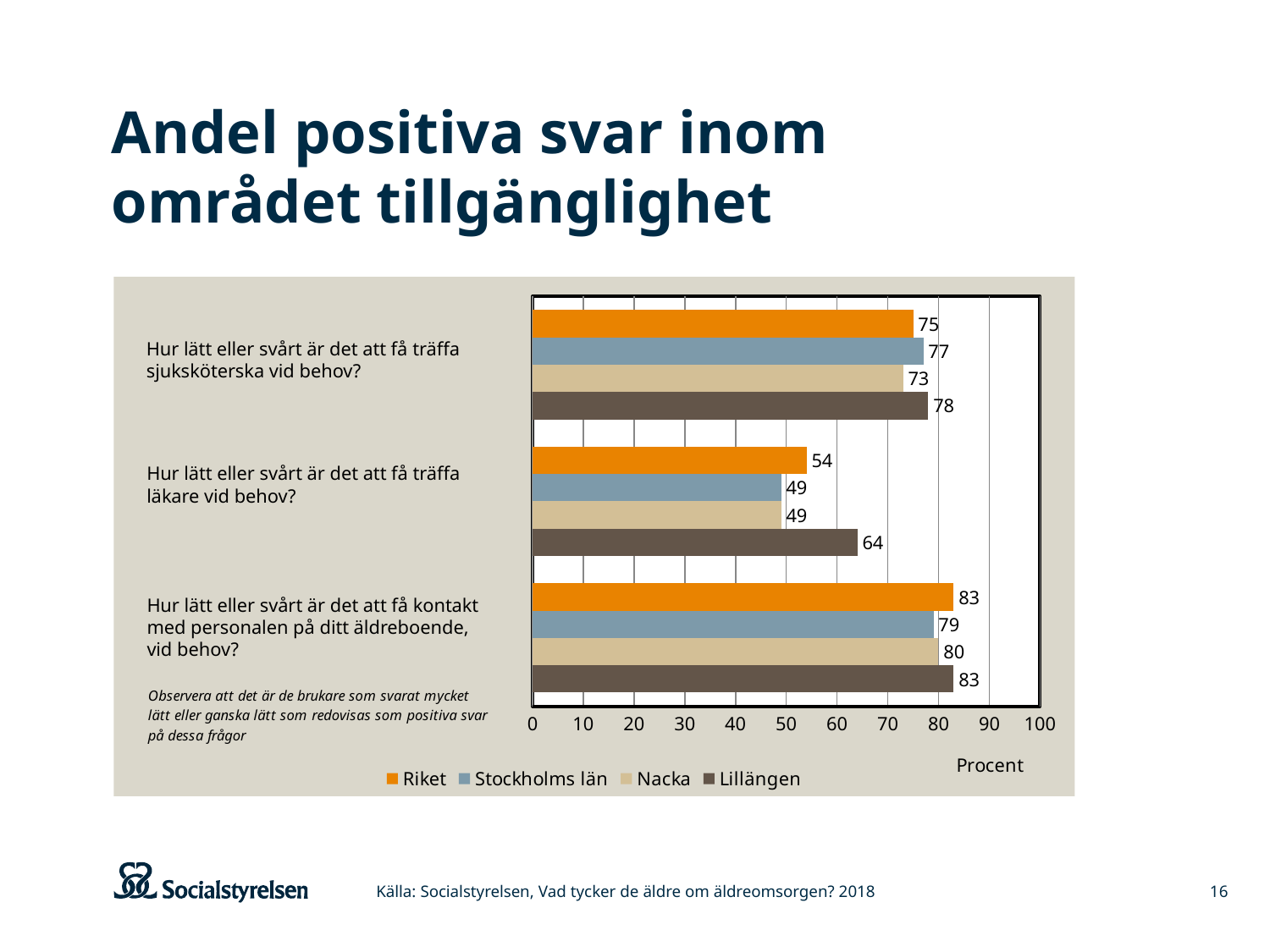
What is the value for Lillängen for the question about meeting a doctor (läkare) when needed? 64 Which is larger for the question about getting in contact with staff: Riket or Nacka? Riket How many questions (categories) are shown on the chart? 3 What is the difference between Riket and Stockholms län for the question about meeting a doctor (läkare) when needed? 5 Which series is shown in orange in the legend? Riket How many series does the legend list? 4 Which series has the lowest value for the question about meeting a nurse (sjuksköterska) when needed? Nacka What is the value for Nacka for the question about meeting a nurse (sjuksköterska) when needed? 73 Which series has the highest value for the question about meeting a doctor (läkare) when needed? Lillängen What is the value for Stockholms län for the question about getting in contact with staff at the care home? 79 What is the label of the x axis? Procent What type of chart is shown on the slide? Bar chart